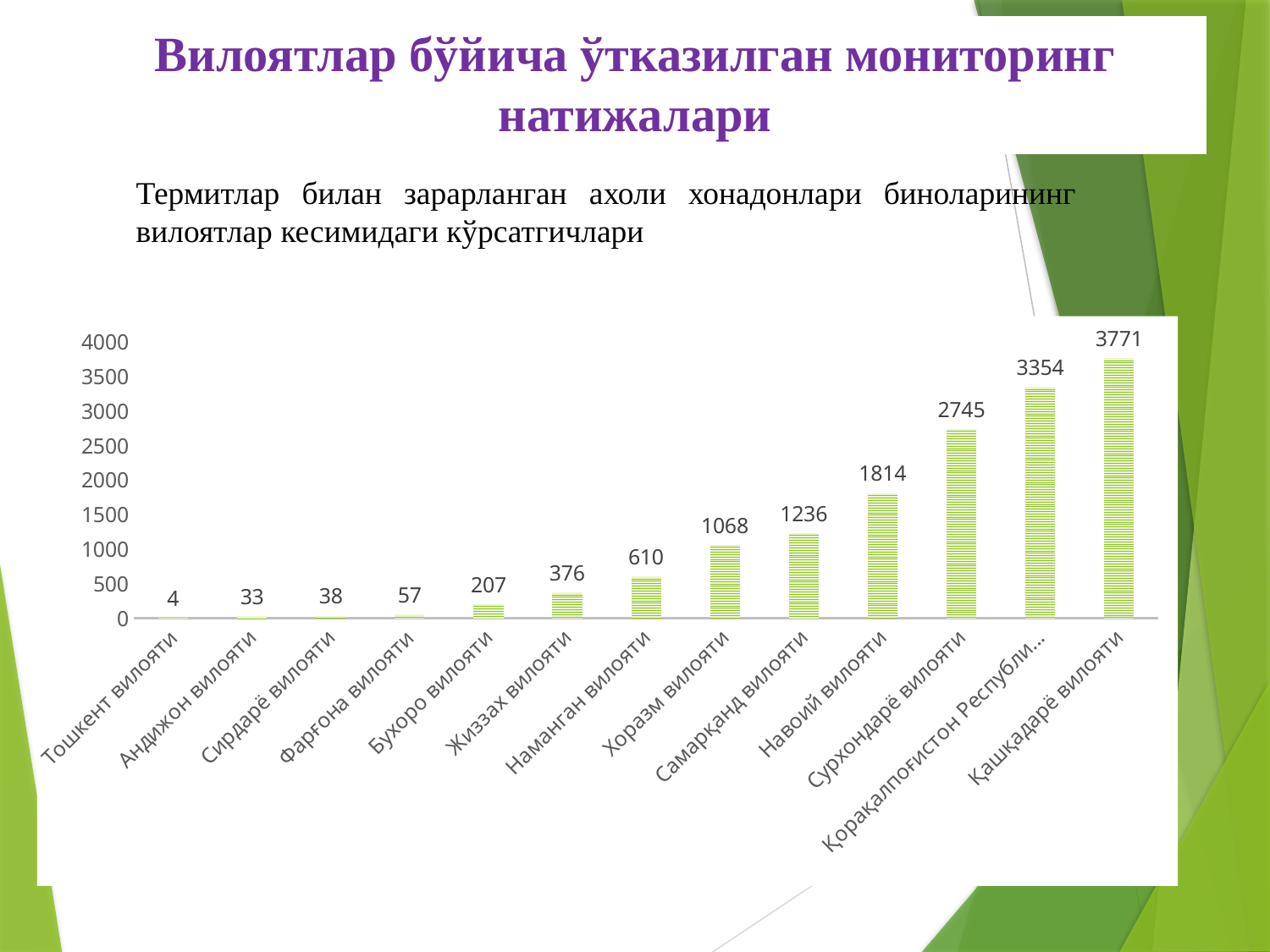
Which is larger, the value for Хоразм вилояти or the value for Самарқанд вилояти? Самарқанд вилояти What is the value for Қашқадарё вилояти? 3771 What is the value for Наманган вилояти? 610 Is the value for Навоий вилояти greater or less than 1500? greater What is the difference between the values for Сурхондарё вилояти and Навоий вилояти? 931 Which region has the lowest value in the chart? Тошкент вилояти Do the values rise or fall moving from left to right along the x axis? rise Which region has the highest value in the chart? Қашқадарё вилояти How many categories (regions) are plotted in the chart? 13 What type of chart is shown on the slide? bar chart What is the difference between the values for Жиззах вилояти and Фарғона вилояти? 319 What is the value for Бухоро вилояти? 207